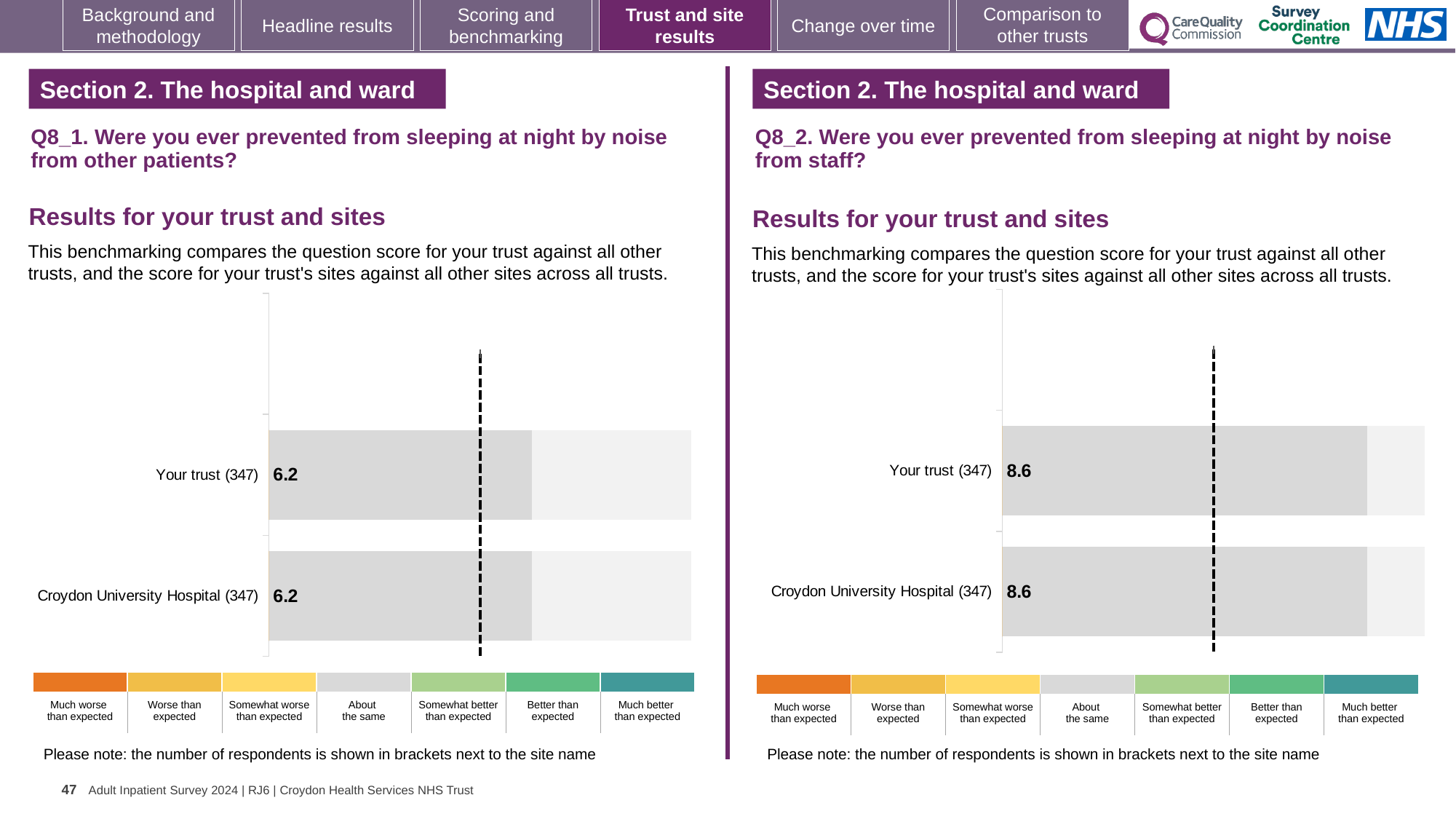
How many bars are plotted in the Q8_2 chart on the right? 2 In the Q8_2 chart on the right, which benchmark category does the grey colour of the bars correspond to in the legend? About the same How many bars are plotted in the Q8_1 chart on the left? 2 In the Q8_1 chart on the left, what is the difference between the score for Your trust and the score for Croydon University Hospital? 0.0 In the Q8_1 chart on the left, how many respondents are shown in brackets next to Croydon University Hospital? 347 In the Q8_2 chart on the right, what is the difference between the score for Your trust and the score for Croydon University Hospital? 0.0 In the Q8_2 chart on the right, what is the score for Your trust (347)? 8.6 In the Q8_1 chart on the left, what is the score for Your trust (347)? 6.2 In the Q8_2 chart on the right, what is the score for Croydon University Hospital (347)? 8.6 In the Q8_1 chart on the left, what is the score for Croydon University Hospital (347)? 6.2 What kind of chart is used for the Q8_2 results on the right? Bar chart